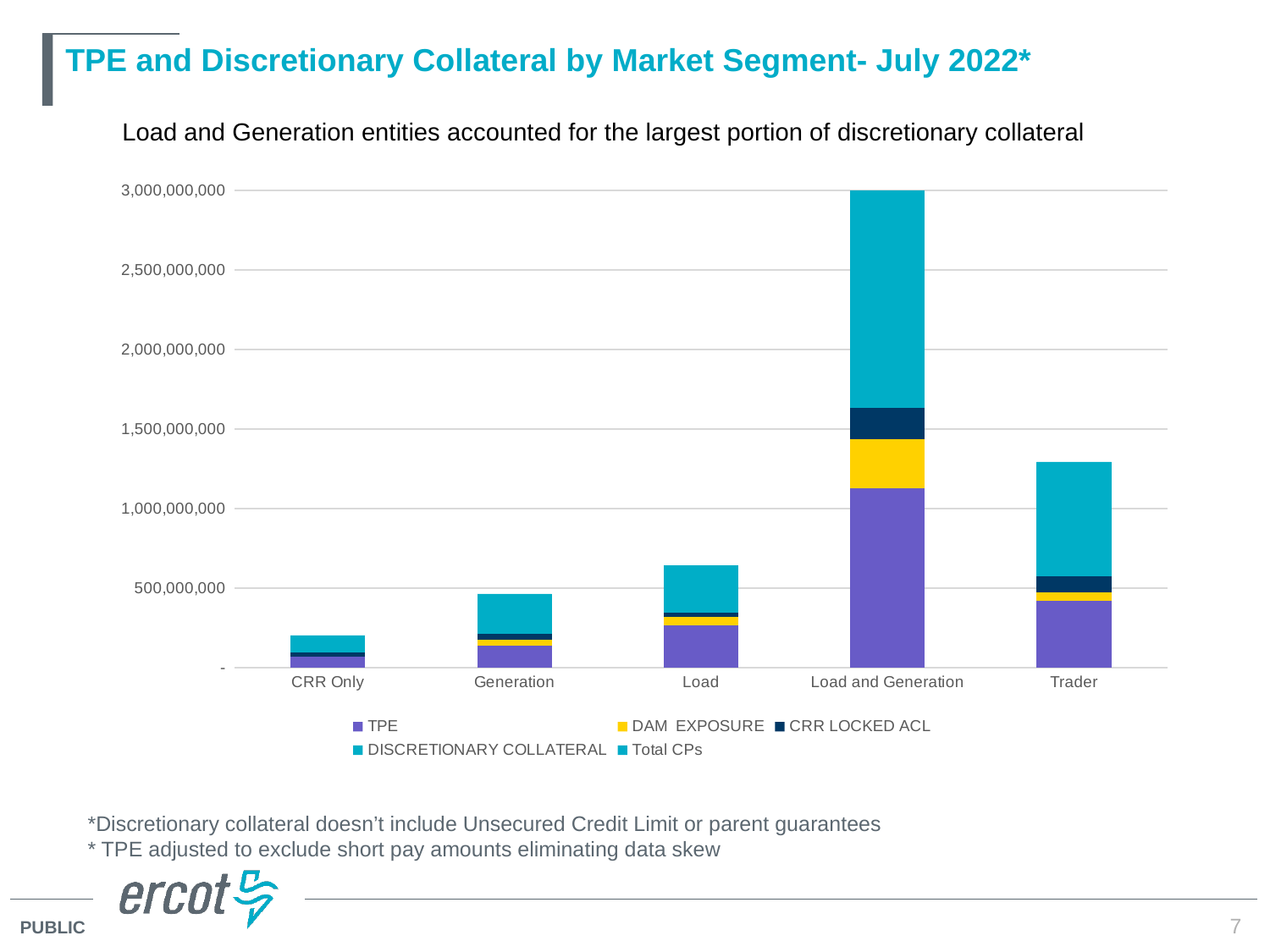
Which market segment has the tallest stacked bar? Load and Generation Is the total stacked value for Trader greater or less than 1,000,000,000? greater Is the total stacked value for CRR Only greater or less than 500,000,000? less How many market segment categories are shown on the x axis? 5 Is the total stacked value for Load and Generation greater or less than 2,500,000,000? greater Which stacked bar is taller, Trader or Load? Trader How many series does the legend list? 5 Which market segment has the shortest stacked bar? CRR Only What kind of chart is shown on the slide? bar chart What is the title of the slide containing the chart? TPE and Discretionary Collateral by Market Segment- July 2022*